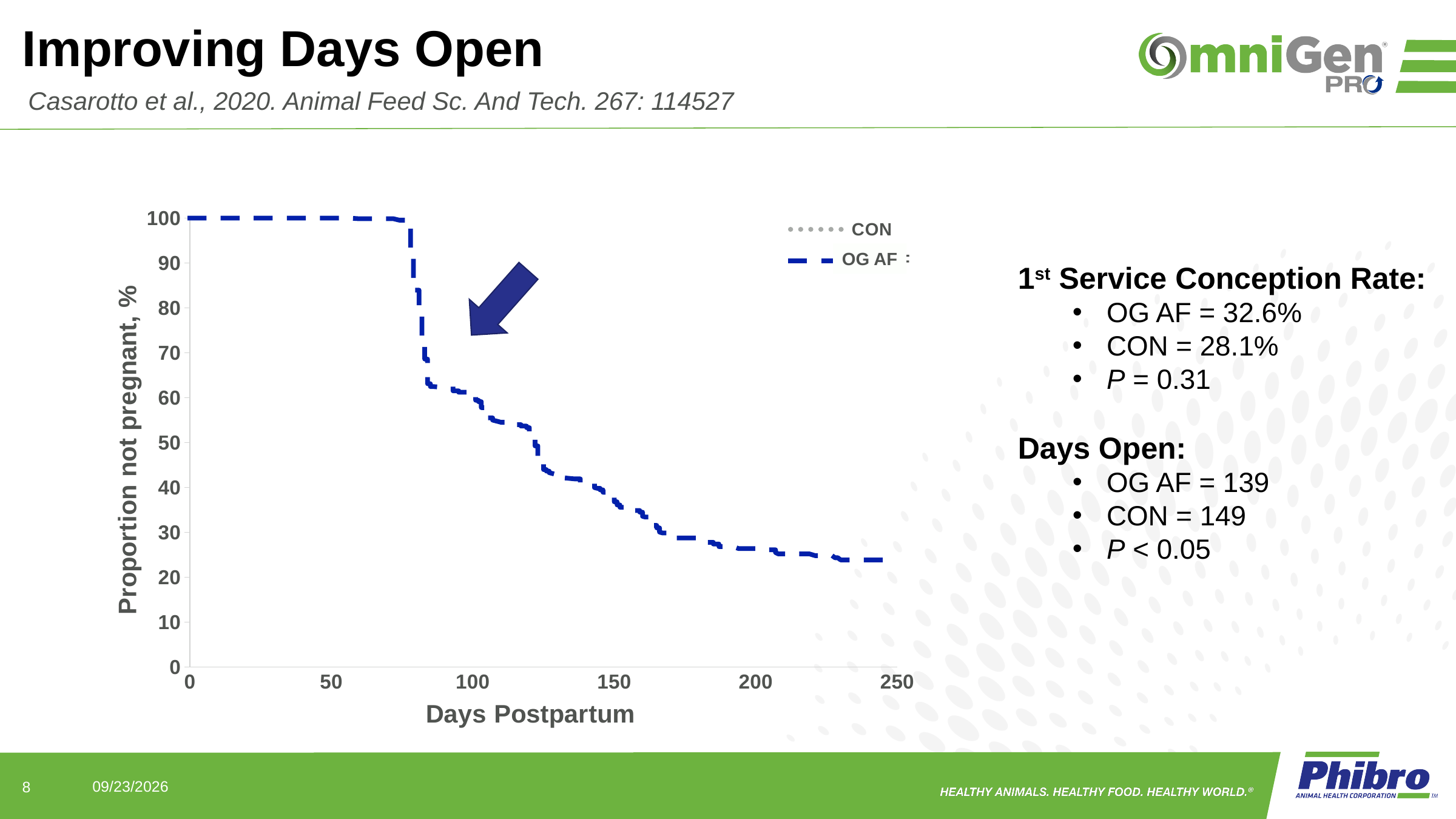
Is the OG AF value at 150 days postpartum greater or less than 50? less What is the label of the x axis of the chart? Days Postpartum Is the OG AF value at 100 days postpartum greater or less than 70? less What is the proportion not pregnant for OG AF at 50 days postpartum? 100 What kind of chart is shown on the slide? line chart Is the OG AF value at 100 days postpartum greater or less than 50? greater How many series does the chart legend list? 2 What is the proportion not pregnant for OG AF at 0 days postpartum? 100 Which two series are listed in the chart legend? CON and OG AF Does the OG AF line rise or fall as days postpartum increase? fall